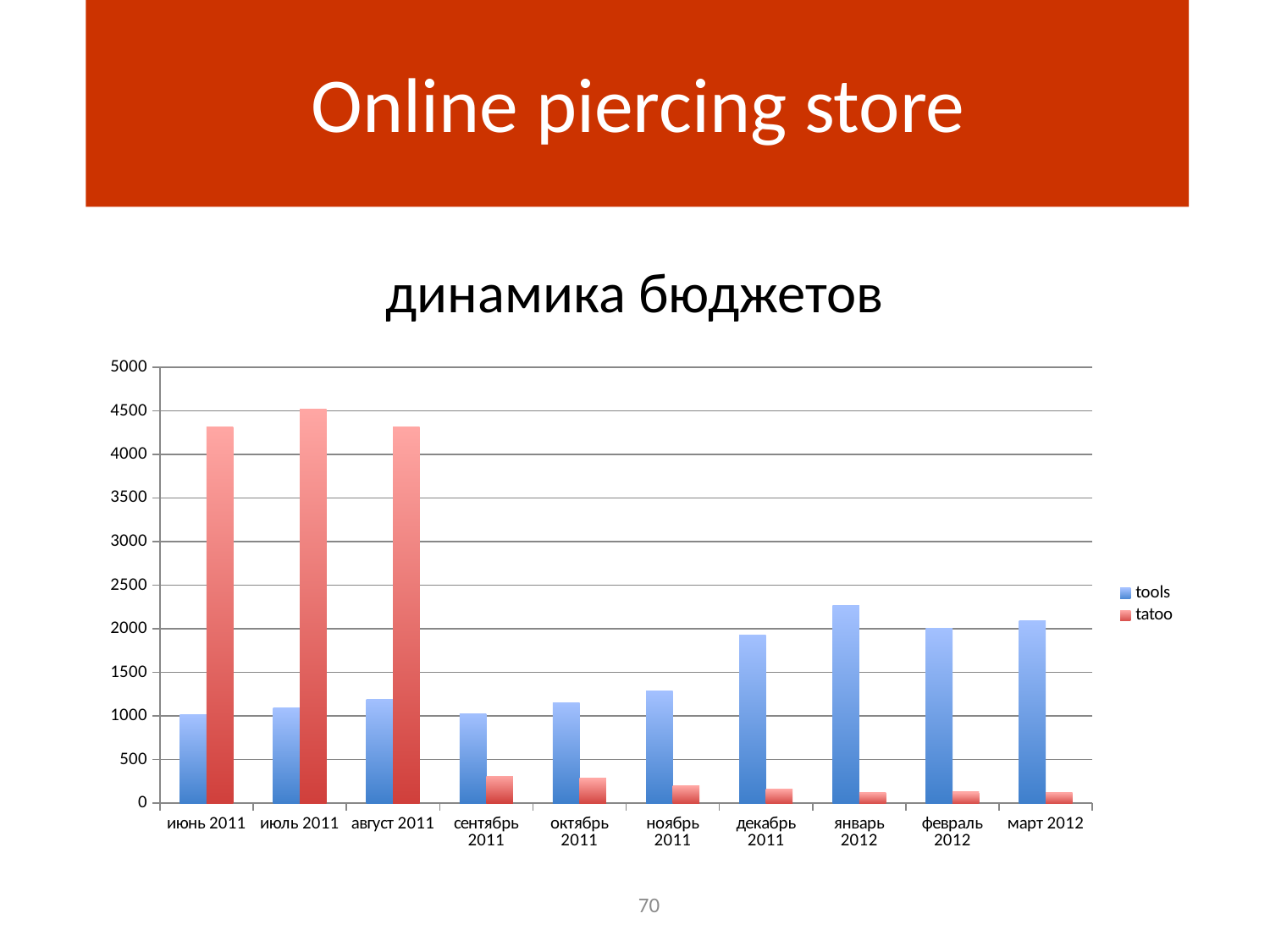
Is the tatoo value for июнь 2011 greater or less than 4000? greater What is the title of the chart? динамика бюджетов In which month is the tools value highest? январь 2012 In which month is the tatoo value highest? июль 2011 How many series does the legend list? 2 Is the tools value for январь 2012 greater or less than 2000? greater What kind of chart is shown on the slide? bar chart Is the tools value for ноябрь 2011 greater or less than 1000? greater In июнь 2011, which series has the larger value, tools or tatoo? tatoo Does the tatoo series generally rise or fall from июнь 2011 to март 2012? fall How many months are shown on the x axis? 10